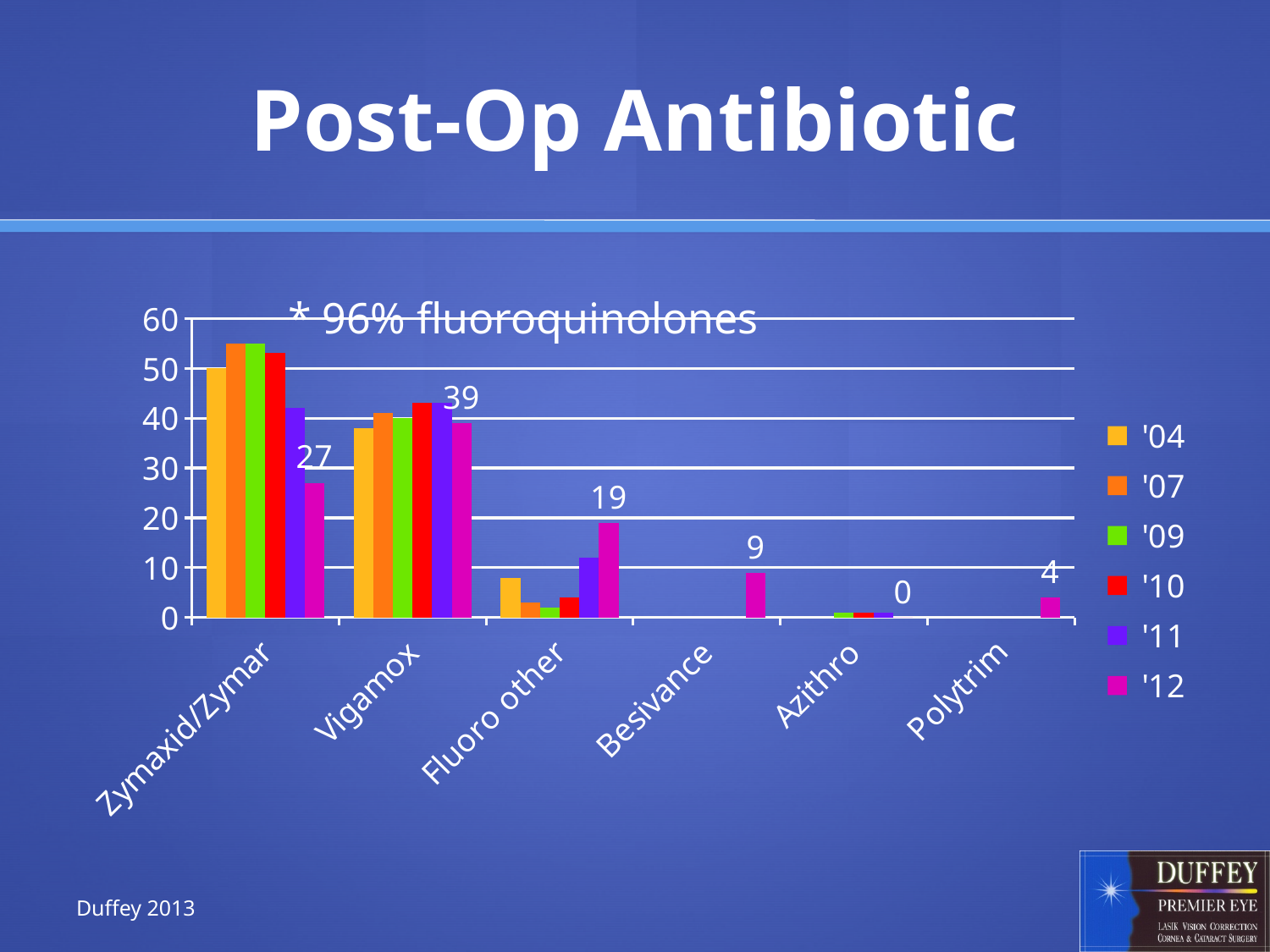
What is the value for Azithro in the '12 series? 0 What is the difference between the '12 values for Vigamox and Zymaxid/Zymar? 12 Which category has the lowest value in the '12 series? Azithro What is the value for Vigamox in the '12 series? 39 What is the value for Fluoro other in the '12 series? 19 Is the value for Zymaxid/Zymar in the '07 series greater or less than 50? greater What is the value for Zymaxid/Zymar in the '12 series? 27 How many antibiotic categories are shown on the x axis? 6 Which category has the highest value in the '12 series? Vigamox In the '12 series, which is larger: Besivance or Polytrim? Besivance What kind of chart is shown on the slide? bar chart How many series does the legend list? 6